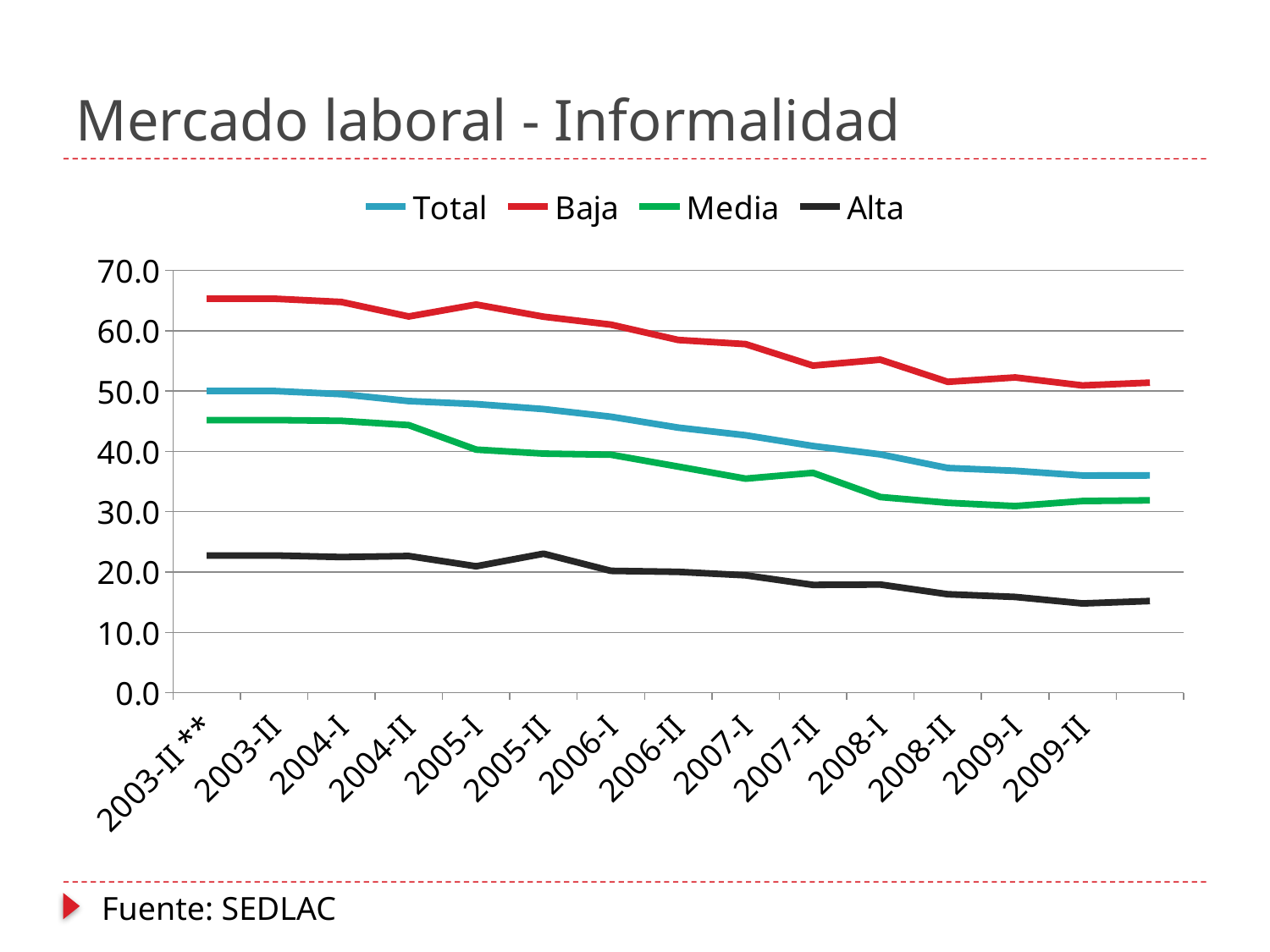
Which series has the highest values throughout the chart? Baja What is the title of the slide containing the chart? Mercado laboral - Informalidad What kind of chart is shown on the slide? line chart Which series has the lowest values throughout the chart? Alta Is the value for Baja at 2003-II ** greater or less than 60.0? greater At 2007-I, which series has the larger value, Media or Alta? Media Does the Total series rise or fall over the period shown? fall How many series does the legend list? 4 Is the value for Total at 2009-II greater or less than 40.0? less Does the Baja series rise or fall from 2003-II ** to 2009-II? fall Is the value for Media at 2003-II greater or less than 40.0? greater